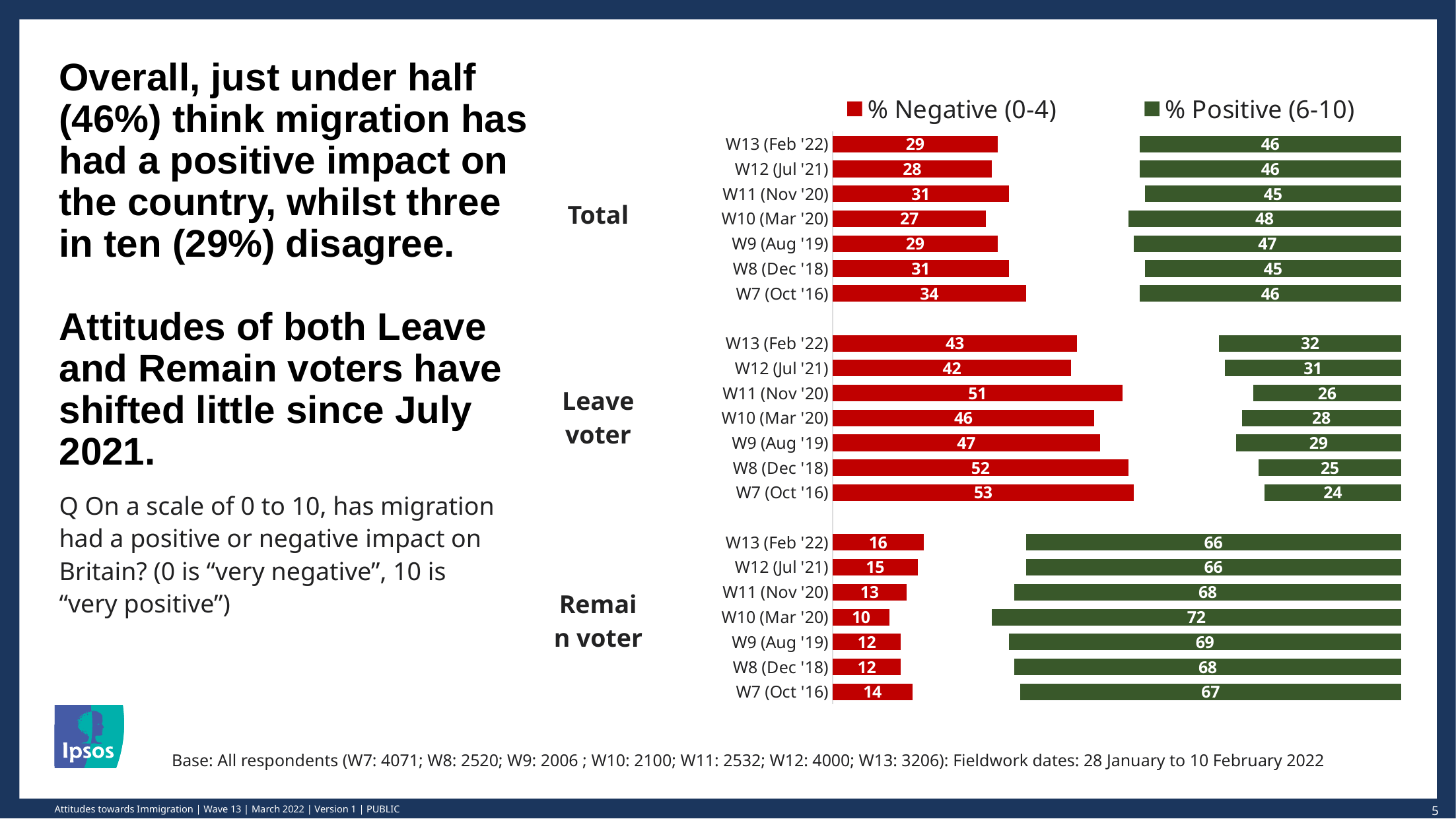
How many series does the chart legend list? 2 Among the Remain voter waves, which wave has the highest % Positive (6-10) value? W10 (Mar '20) What is the % Negative (0-4) value for Total at W13 (Feb '22)? 29 How many waves are shown for each voter group in the chart? 7 What kind of chart is shown on the slide? Bar chart What is the % Positive (6-10) value for Remain voters at W10 (Mar '20)? 72 For Leave voters at W13 (Feb '22), what is the difference between the % Negative (0-4) and % Positive (6-10) values? 11 Among the Leave voter waves, which wave has the highest % Negative (0-4) value? W7 (Oct '16) Among the Remain voter waves, which wave has the lowest % Negative (0-4) value? W10 (Mar '20) For Remain voters at W13 (Feb '22), how much larger is the % Positive (6-10) value than the % Negative (0-4) value? 50 What is the % Positive (6-10) value for Leave voters at W11 (Nov '20)? 26 For Total, is the % Negative (0-4) value larger at W7 (Oct '16) or at W13 (Feb '22)? W7 (Oct '16)